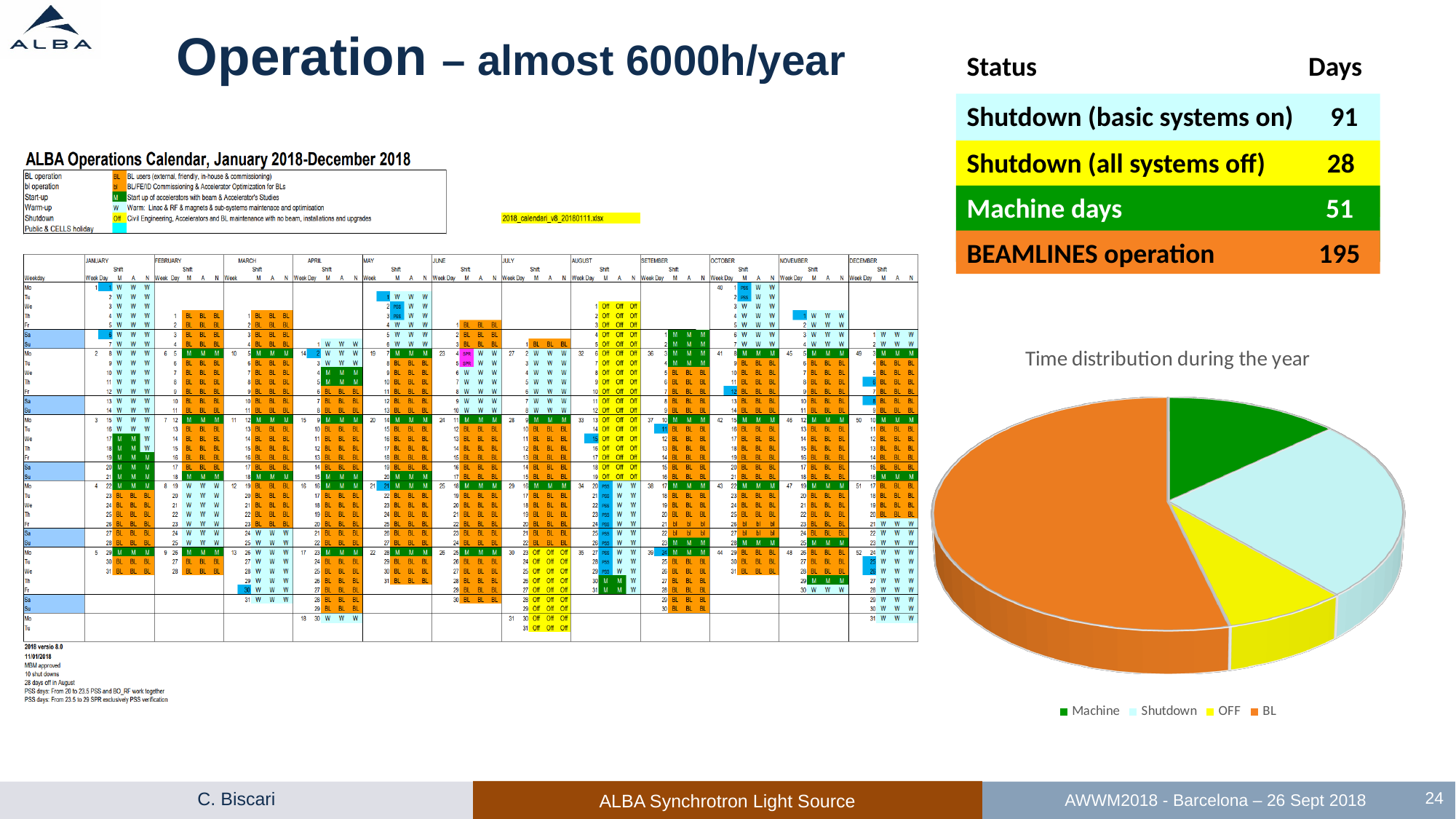
What are the legend entries of the 'Time distribution during the year' pie chart? Machine, Shutdown, OFF, BL In the 'Time distribution during the year' pie chart, what colour is the BL slice? orange In the 'Time distribution during the year' pie chart, which slice is larger, BL or Shutdown? BL How many series does the legend of the 'Time distribution during the year' pie chart list? 4 In the 'Time distribution during the year' pie chart, which category has the largest slice? BL In the Status/Days table, how many days are listed for 'Machine days'? 51 What kind of chart is 'Time distribution during the year'? pie chart In the Status/Days table, what is the difference in days between 'Shutdown (basic systems on)' and 'Shutdown (all systems off)'? 63 In the 'Time distribution during the year' pie chart, which slice is larger, Machine or Shutdown? Shutdown In the Status/Days table, how many days are listed for 'BEAMLINES operation'? 195 In the Status/Days table, how many days are listed for 'Shutdown (all systems off)'? 28 In the 'Time distribution during the year' pie chart, which category has the smallest slice? OFF